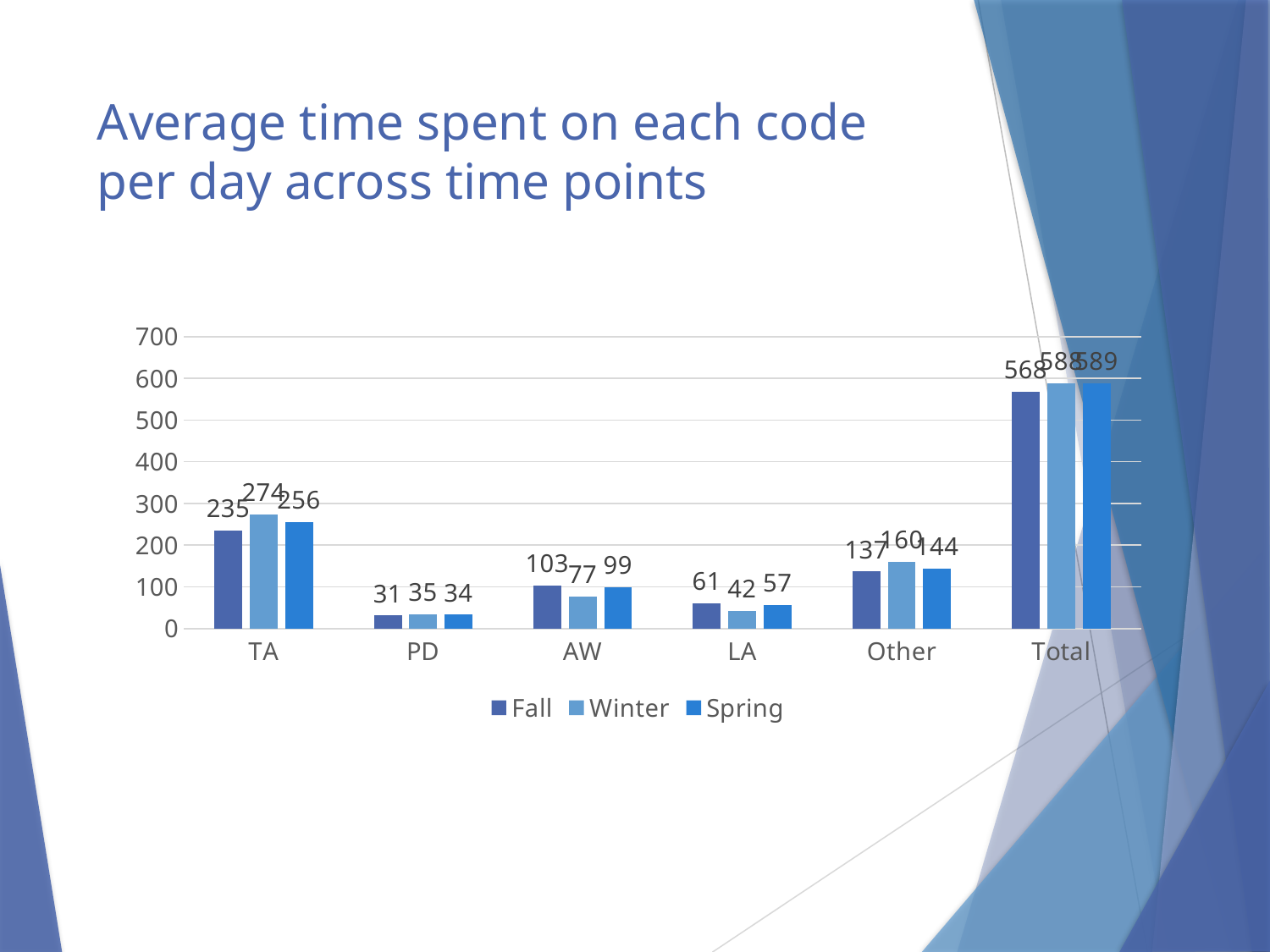
What kind of chart is shown on the slide? bar chart What is the difference between the Fall and Winter values for LA? 19 How many categories are shown on the x axis? 6 Which is larger for AW, the Fall value or the Spring value? Fall What is the Spring value for AW? 99 What is the Winter value for Other? 160 Which category has the highest Winter value? Total What is the difference between the Winter and Fall values for TA? 39 Which category has the lowest Fall value? PD How many series does the legend list? 3 What is the Fall value for TA? 235 Is the Fall value for Total greater or less than 500? greater